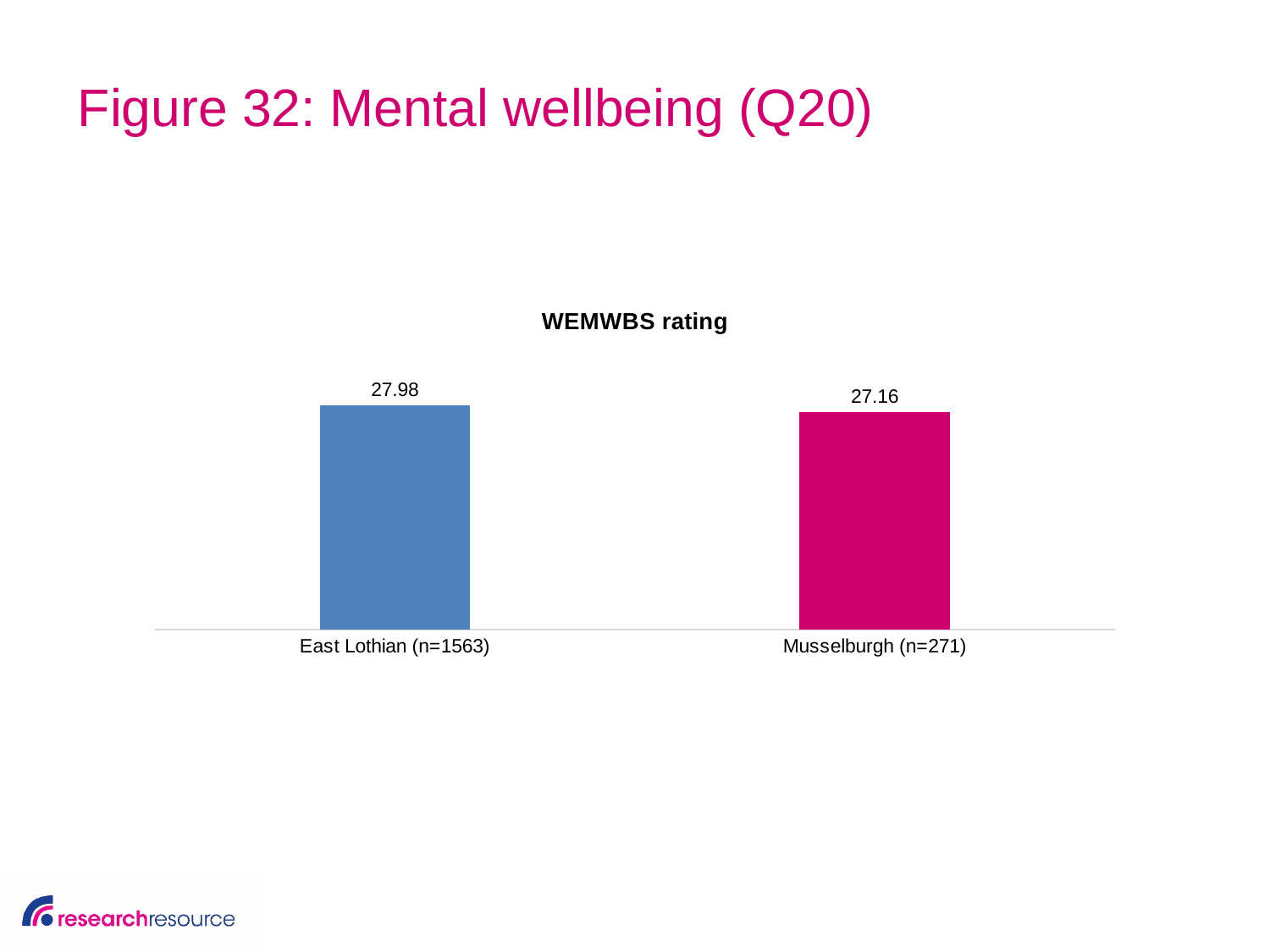
Which category has the highest WEMWBS rating? East Lothian (n=1563) What is the WEMWBS rating for Musselburgh (n=271)? 27.16 What colour is the bar for Musselburgh (n=271)? Pink/magenta How many categories are shown in the chart? 2 What is the WEMWBS rating for East Lothian (n=1563)? 27.98 What kind of chart is shown on the slide? Bar chart Which has a higher WEMWBS rating, East Lothian (n=1563) or Musselburgh (n=271)? East Lothian (n=1563) What is the title of the chart? WEMWBS rating What is the difference between the WEMWBS ratings for East Lothian (n=1563) and Musselburgh (n=271)? 0.82 Which category has the lowest WEMWBS rating? Musselburgh (n=271)